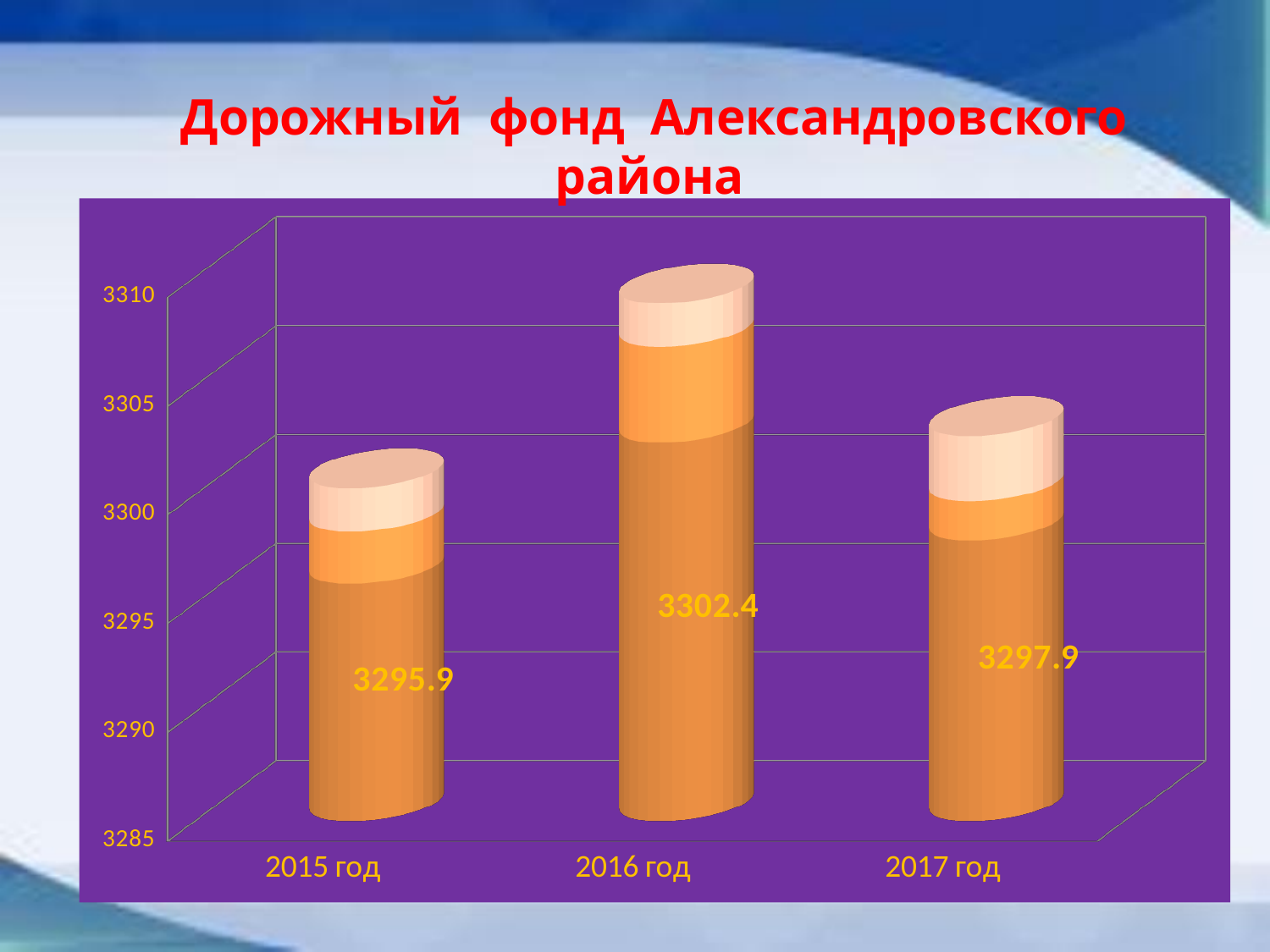
What is the value for 2016 год? 3302.4 Which year has the highest value? 2016 год Which is larger, the value for 2017 год or the value for 2015 год? 2017 год What is the title of the chart? Дорожный фонд Александровского района What is the difference between the values for 2016 год and 2015 год? 6.5 Is the value for 2016 год greater or less than 3300? greater What is the difference between the values for 2016 год and 2017 год? 4.5 What is the value for 2017 год? 3297.9 What is the value for 2015 год? 3295.9 Which year has the lowest value? 2015 год How many categories are shown on the x axis? 3 What kind of chart is shown on the slide? bar chart